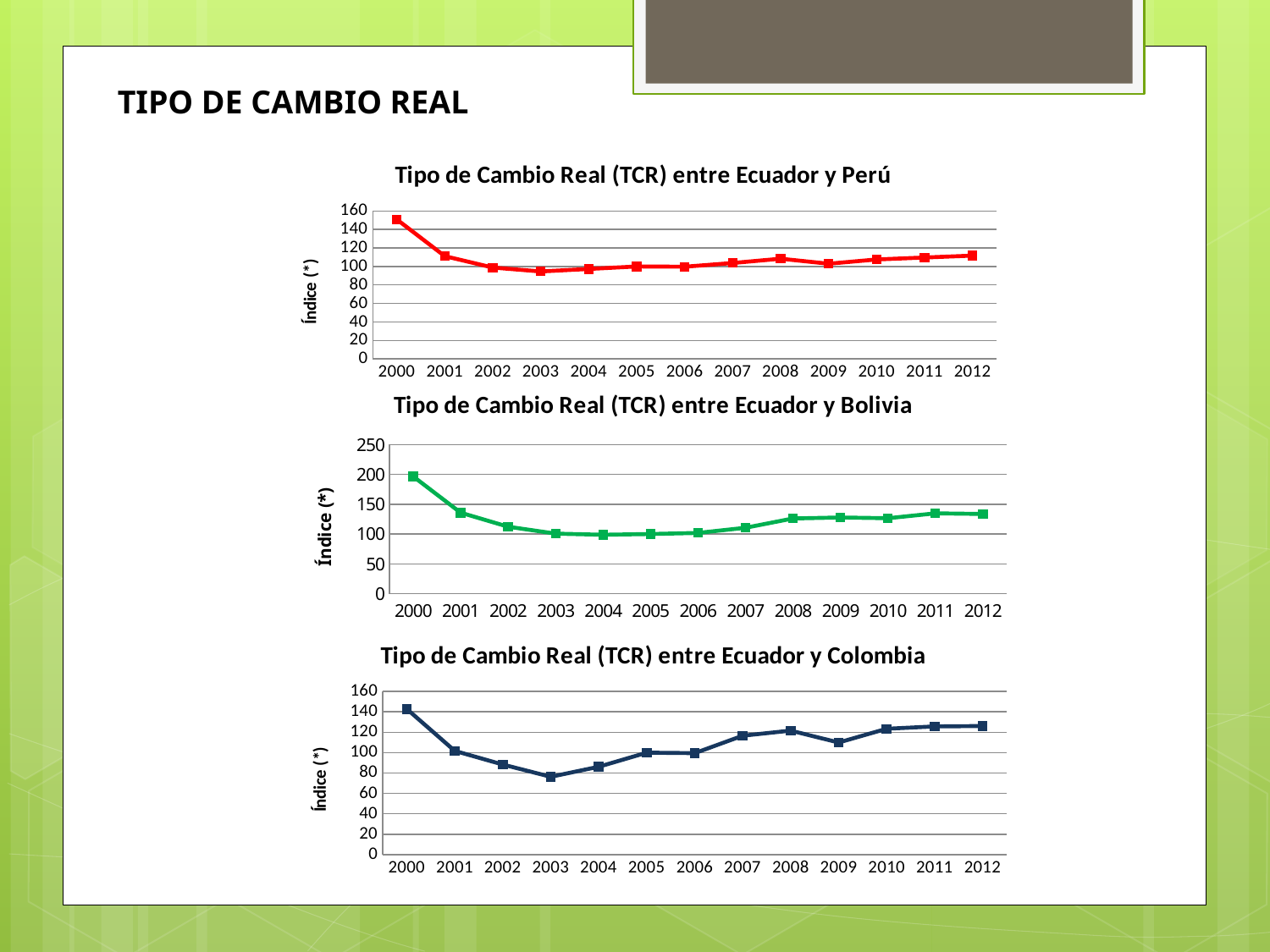
How many charts are shown on the slide? 3 In the 'Tipo de Cambio Real (TCR) entre Ecuador y Bolivia' chart, which year has the highest value? 2000 How many data points are plotted in the 'Tipo de Cambio Real (TCR) entre Ecuador y Bolivia' chart? 13 In the 'Tipo de Cambio Real (TCR) entre Ecuador y Colombia' chart, which is larger, the value for 2000 or the value for 2003? 2000 What kind of chart is the 'Tipo de Cambio Real (TCR) entre Ecuador y Perú' chart? line chart What is the y-axis label on the 'Tipo de Cambio Real (TCR) entre Ecuador y Colombia' chart? Índice (*) In the 'Tipo de Cambio Real (TCR) entre Ecuador y Perú' chart, is the value for 2000 greater or less than 140? greater In the 'Tipo de Cambio Real (TCR) entre Ecuador y Perú' chart, which year has the highest value? 2000 In the 'Tipo de Cambio Real (TCR) entre Ecuador y Bolivia' chart, is the value for 2001 greater or less than 150? less In the 'Tipo de Cambio Real (TCR) entre Ecuador y Colombia' chart, which year has the lowest value? 2003 In the 'Tipo de Cambio Real (TCR) entre Ecuador y Bolivia' chart, do the values rise or fall from 2000 to 2003? fall In the 'Tipo de Cambio Real (TCR) entre Ecuador y Colombia' chart, is the value for 2012 greater or less than 120? greater